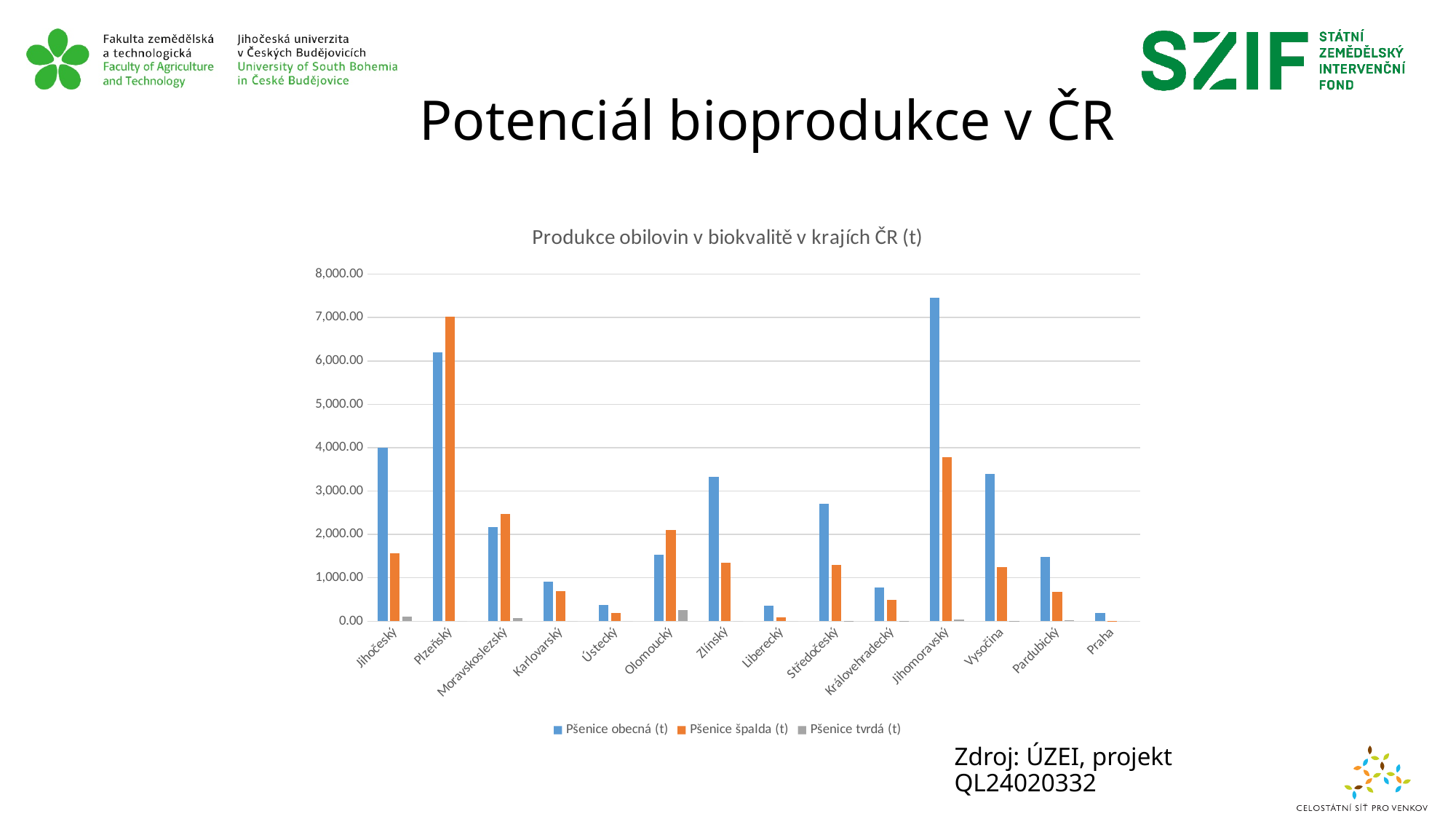
Which region has the highest value for Pšenice špalda (t)? Plzeňský Is the value for Pšenice obecná (t) in Jihomoravský greater or less than 7,000.00? greater What is the title of the chart? Produkce obilovin v biokvalitě v krajích ČR (t) Which region has the lowest value for Pšenice obecná (t)? Praha What kind of chart is shown on the slide? bar chart How many series does the chart legend list? 3 In Jihočeský, which is larger: Pšenice obecná (t) or Pšenice špalda (t)? Pšenice obecná (t) Which region has the highest value for Pšenice obecná (t)? Jihomoravský In Plzeňský, which is larger: Pšenice obecná (t) or Pšenice špalda (t)? Pšenice špalda (t) How many regions (categories) are shown on the x axis of the chart? 14 Is the value for Pšenice obecná (t) in Plzeňský greater or less than 6,000.00? greater Is the value for Pšenice obecná (t) in Karlovarský greater or less than 1,000.00? less